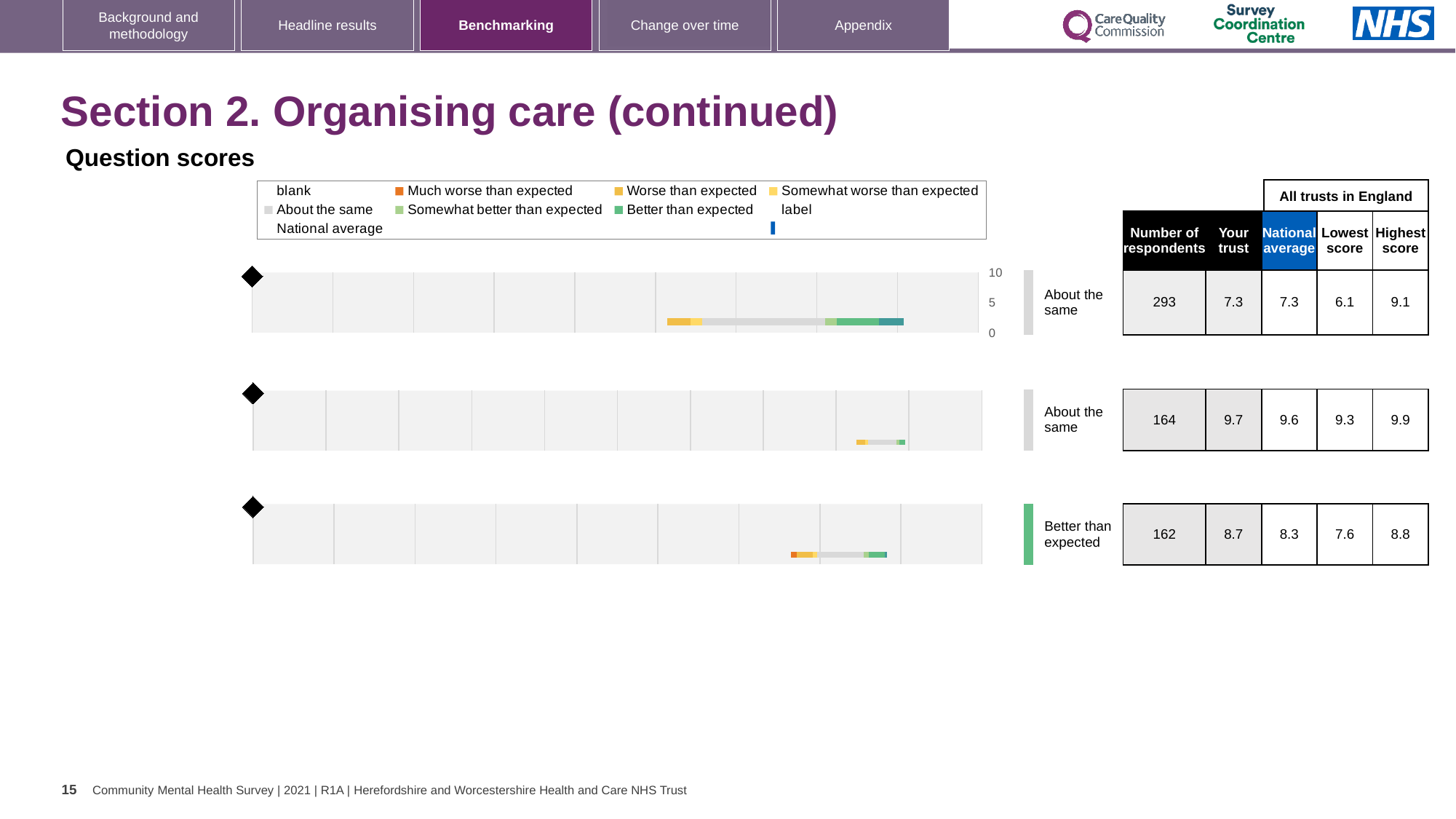
In the bottom chart, what is the national average score? 8.3 Which chart (top, middle or bottom) has the highest 'Your trust' score? middle In the top chart, is the 'Your trust' score greater or less than 5? greater In the bottom chart, what is the difference between the 'Your trust' score and the national average? 0.4 In the top chart, what is the 'Your trust' score? 7.3 In the top chart, what is the lowest score among all trusts in England? 6.1 In the middle chart, what is the highest score among all trusts in England? 9.9 How many benchmarking charts are shown on the slide? 3 In the bottom chart, which is larger: the 'Your trust' score or the national average? Your trust What benchmark category is the bottom chart labelled with? Better than expected Which chart (top, middle or bottom) has the lowest number of respondents? bottom In the middle chart, how many respondents are there? 164